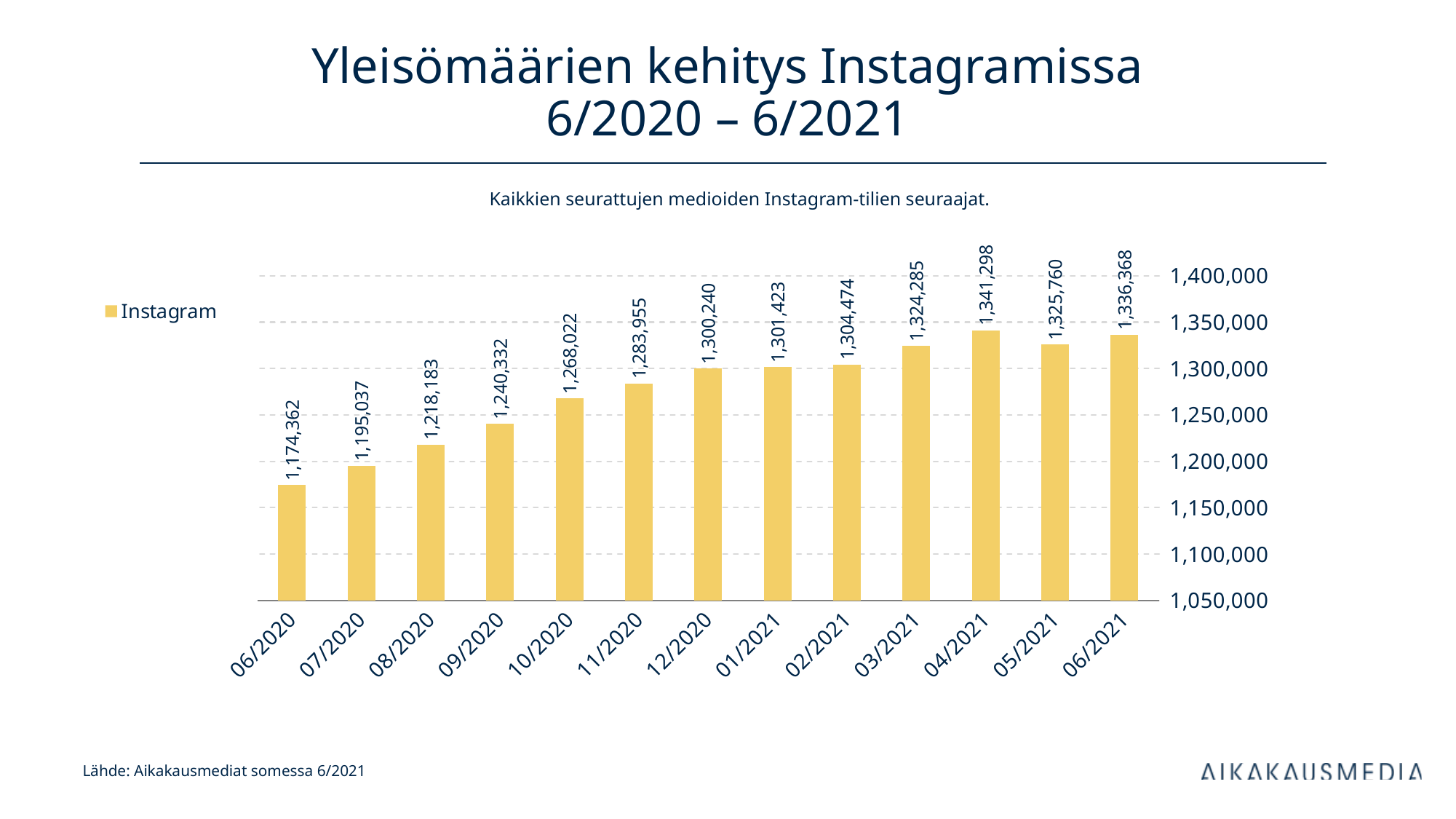
Which month has the highest value? 04/2021 What series does the legend list? Instagram What is the difference between the values for 06/2021 and 06/2020? 162,006 What is the value for 06/2021? 1,336,368 What is the value for 06/2020? 1,174,362 Is the value for 09/2020 greater or less than 1,250,000? less What is the value for 12/2020? 1,300,240 What kind of chart is shown on the slide? bar chart What is the difference between the values for 04/2021 and 05/2021? 15,538 Which is larger, the value for 03/2021 or the value for 05/2021? 05/2021 Which month has the lowest value? 06/2020 How many months are shown on the x axis? 13